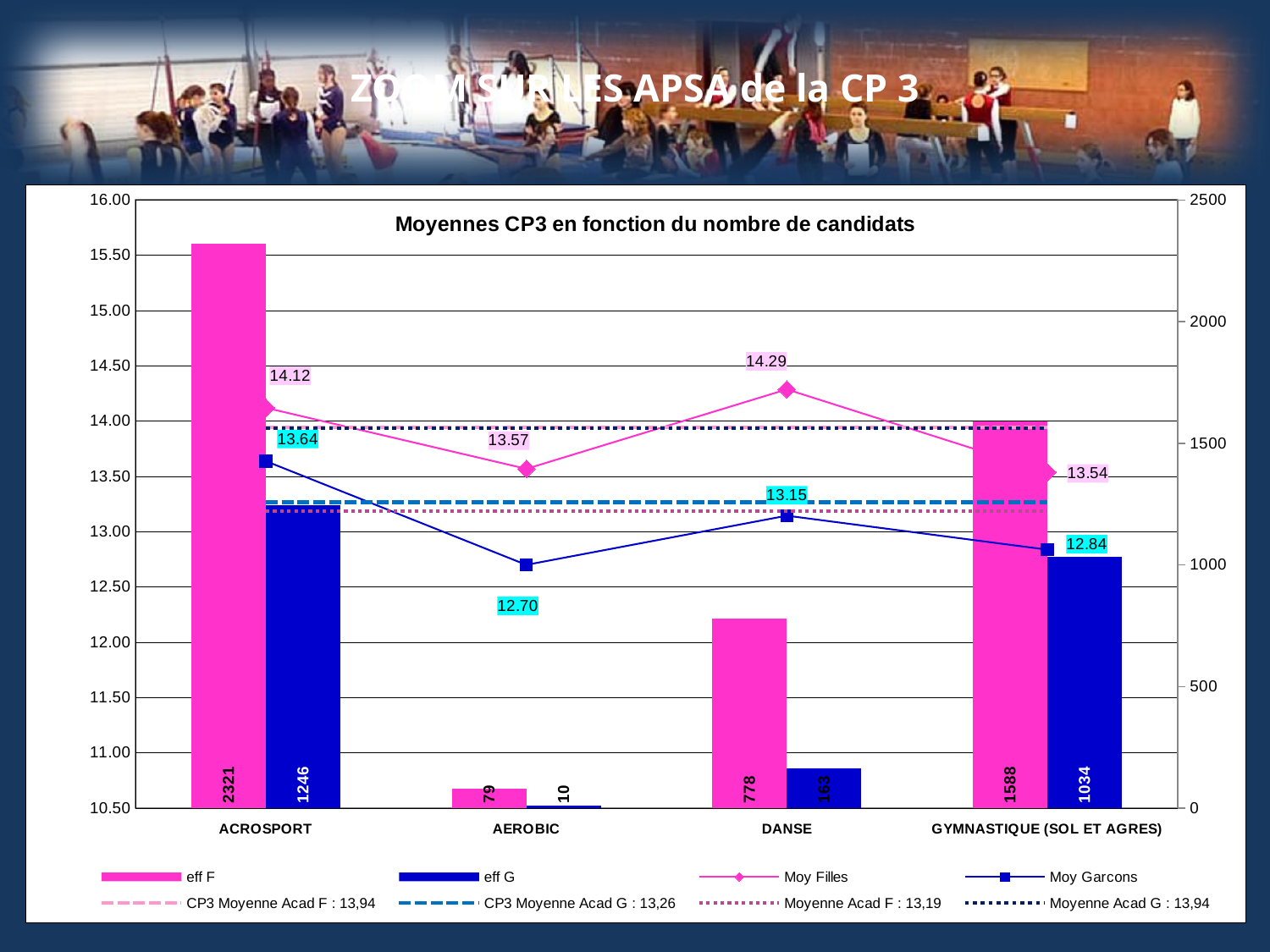
What is the eff G value for DANSE? 163 What is the title of the chart? Moyennes CP3 en fonction du nombre de candidats Which category has the lowest eff G value? AEROBIC What is the difference between the eff F and eff G values for GYMNASTIQUE (SOL ET AGRES)? 554 Which is larger, the Moy Filles value for ACROSPORT or for GYMNASTIQUE (SOL ET AGRES)? ACROSPORT What is the eff F value for ACROSPORT? 2321 How many series does the legend list? 8 How many categories are shown on the x axis? 4 What is the Moy Garcons value for AEROBIC? 12.70 What value does the legend give for CP3 Moyenne Acad G? 13,26 What is the Moy Filles value for DANSE? 14.29 Which category has the highest eff F value? ACROSPORT